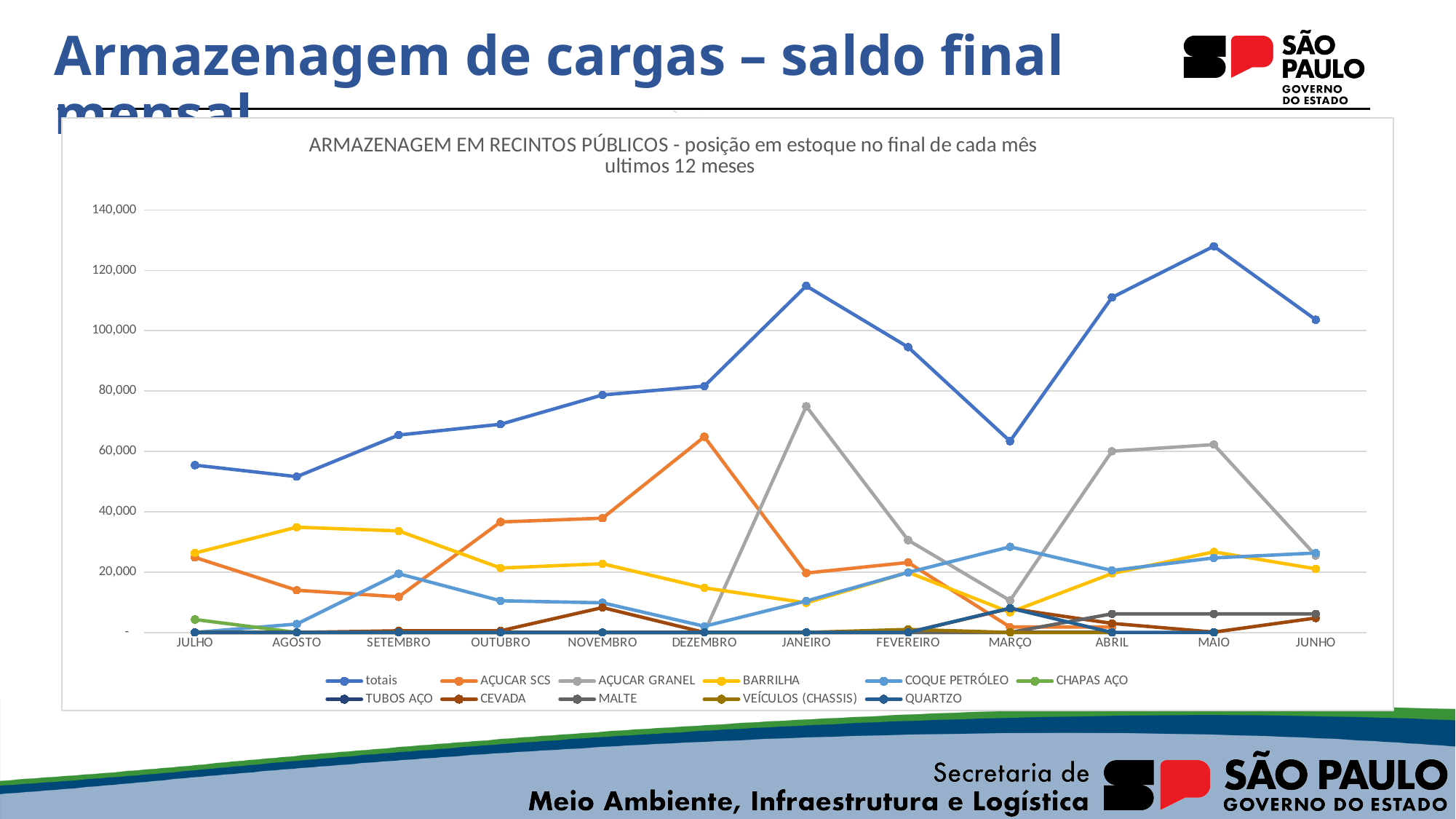
In which month does the 'totais' series reach its highest value? MAIO How many months are shown on the x axis of the chart? 12 How many series does the chart legend list? 11 In which month does the 'totais' series reach its lowest value? AGOSTO Which is larger in DEZEMBRO: 'AÇUCAR SCS' or 'AÇUCAR GRANEL'? AÇUCAR SCS Which is larger for 'totais': MAIO or JUNHO? MAIO What is the title of the chart? ARMAZENAGEM EM RECINTOS PÚBLICOS - posição em estoque no final de cada mês ultimos 12 meses Is the value of 'totais' in MAIO greater or less than 120,000? greater Does the 'totais' series rise or fall from MARÇO to MAIO? rise Is the value of 'AÇUCAR GRANEL' in JANEIRO greater or less than 60,000? greater Is the value of 'totais' in MARÇO greater or less than 80,000? less What kind of chart is shown on the slide? line chart